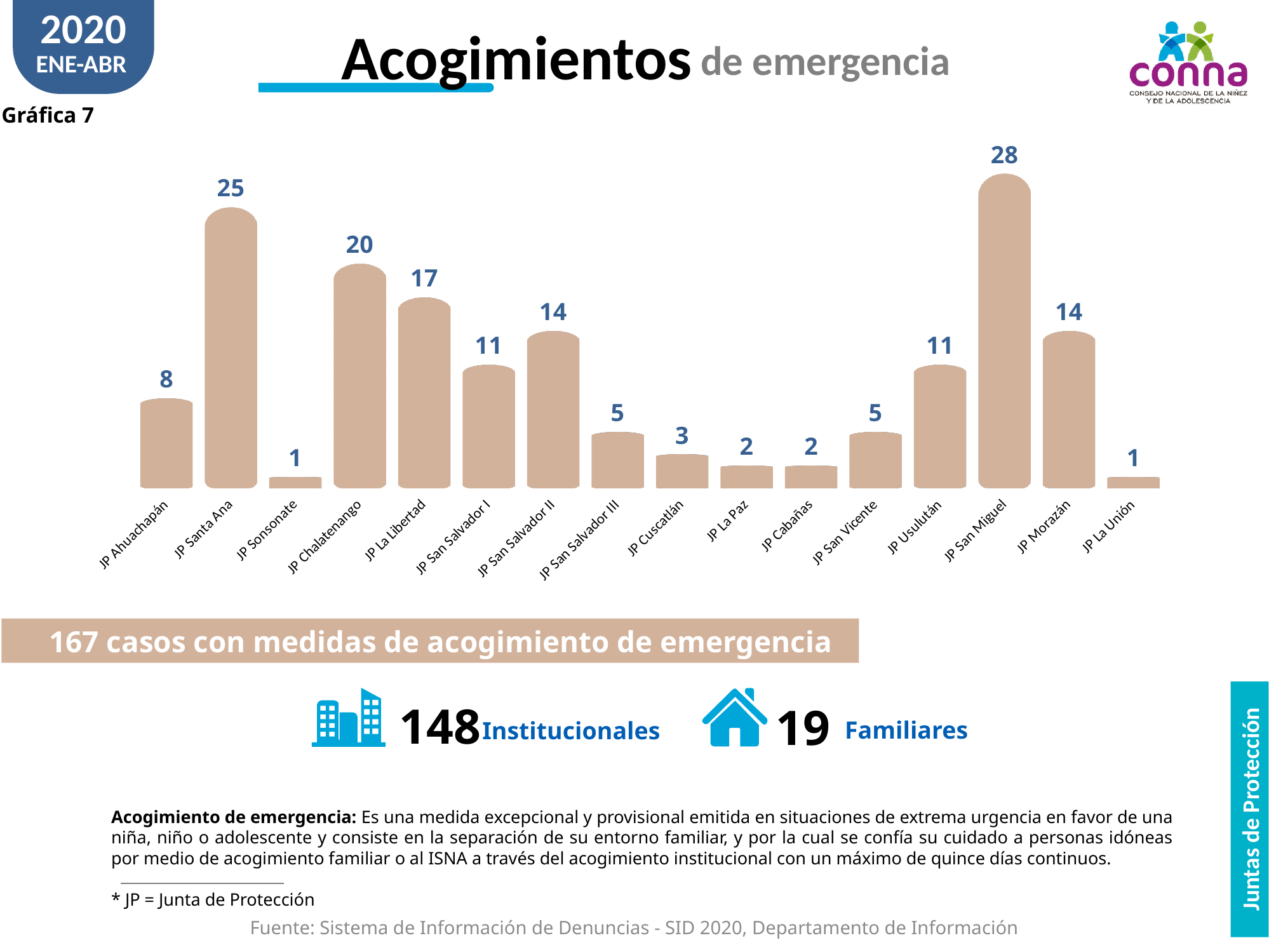
What is the difference between the values for JP La Libertad and JP Ahuachapán? 9 What is the difference between the values for JP San Miguel and JP Santa Ana? 3 What is the title of the chart? Acogimientos de emergencia What kind of chart is shown on the slide? bar chart What is the value for JP Usulután? 11 What is the value for JP Chalatenango? 20 Which is larger, the value for JP San Salvador II or JP San Salvador I? JP San Salvador II What is the value for JP Cuscatlán? 3 What is the value for JP Santa Ana? 25 Which category has the highest value? JP San Miguel How many categories are shown in the chart? 16 Which is larger, the value for JP Morazán or JP San Vicente? JP Morazán